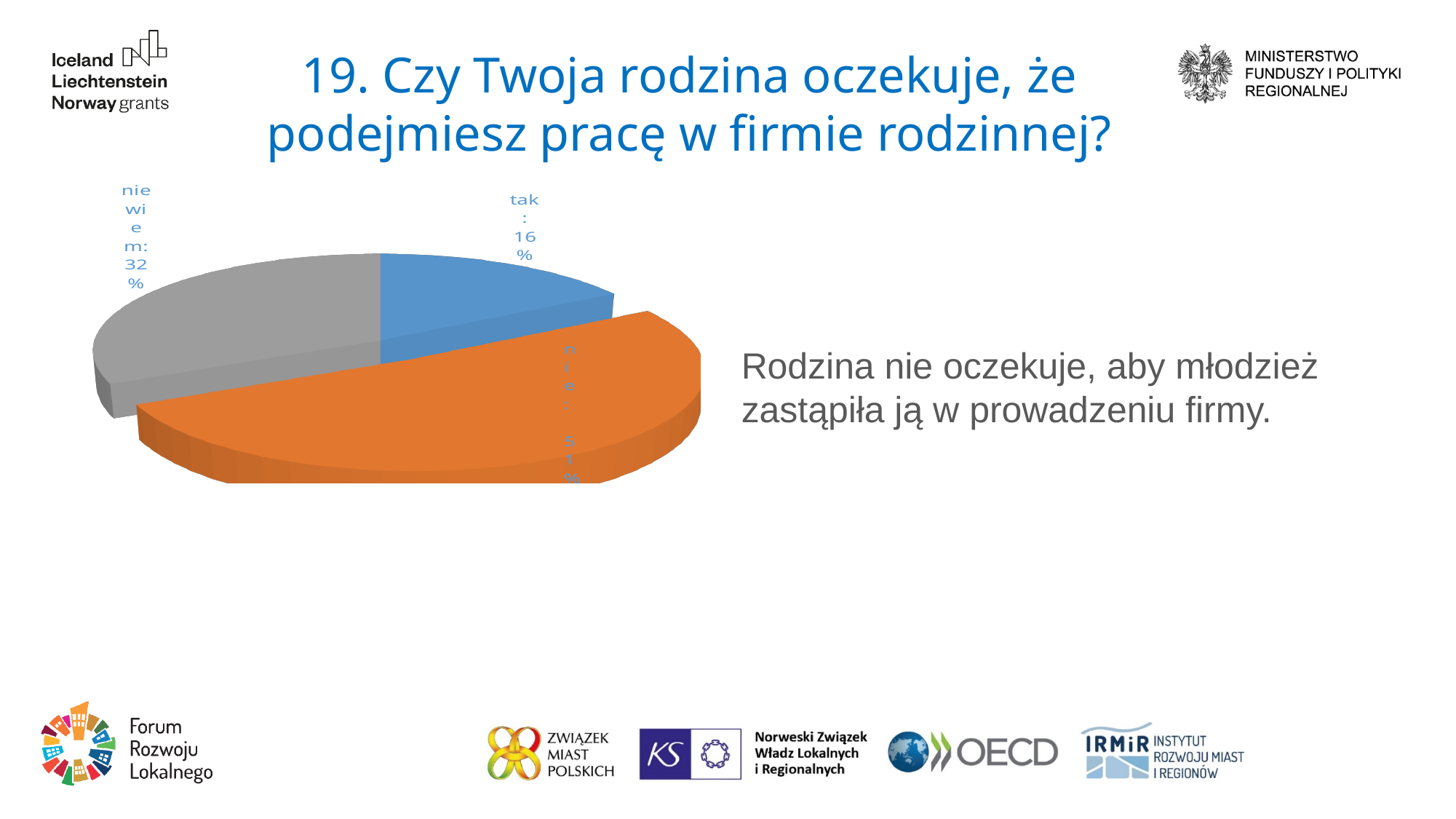
What share of the pie does the "nie" slice represent? 51% What share of the pie does the "tak" slice represent? 16% What kind of chart is shown on the slide? pie chart Which is larger, the "nie wiem" slice or the "tak" slice? nie wiem What is the difference in percentage points between the "nie wiem" slice and the "tak" slice? 16 How many slices does the pie chart have? 3 Which answer category has the smallest slice of the pie? tak What is the difference in percentage points between the "nie" slice and the "nie wiem" slice? 19 What colour is the "tak" slice of the pie chart? blue What colour is the "nie" slice of the pie chart? orange What share of the pie does the "nie wiem" slice represent? 32% Which answer category has the largest slice of the pie? nie